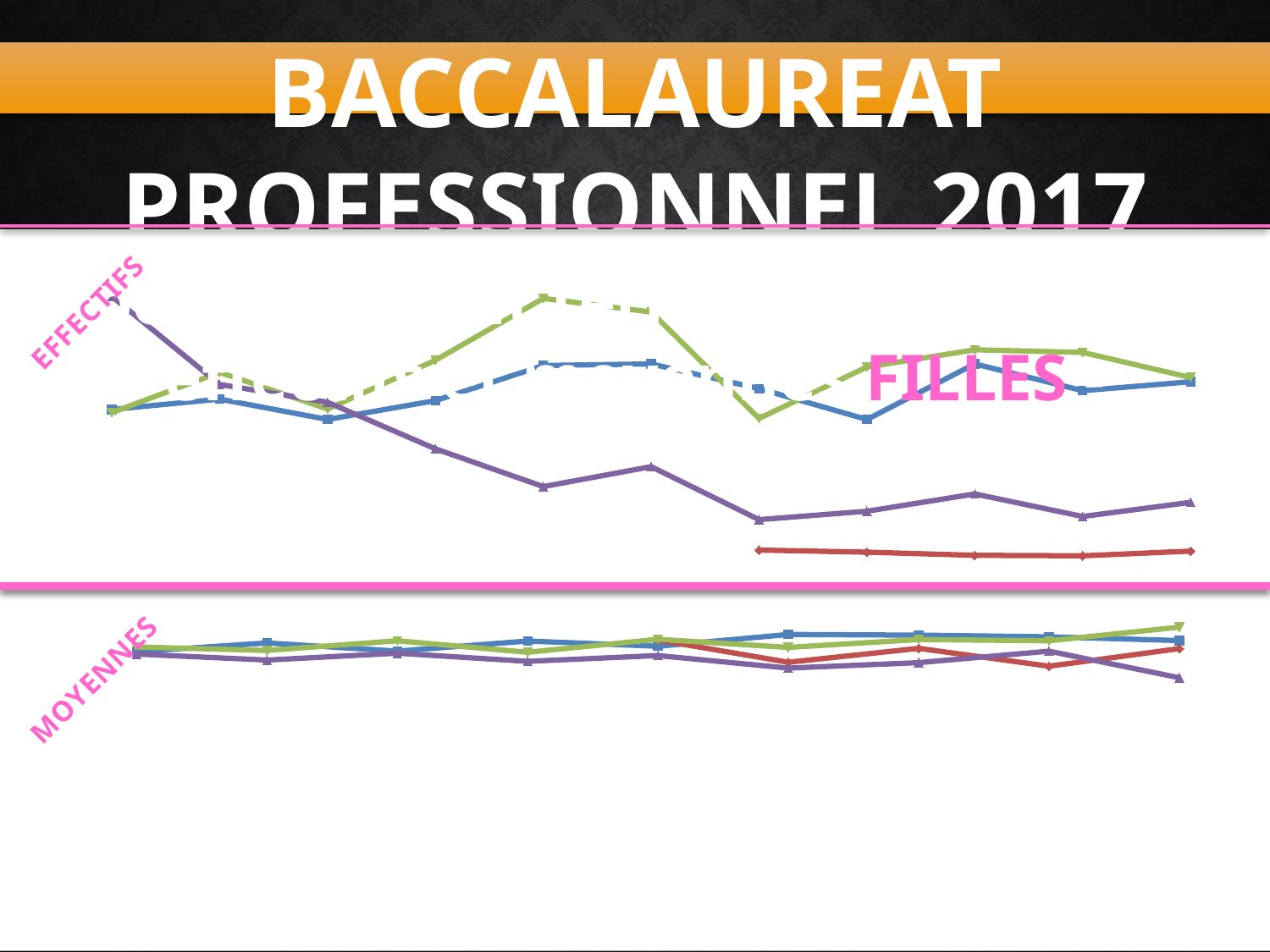
In the top chart (EFFECTIFS), does the purple line rise or fall overall from left to right? fall In the bottom chart (MOYENNES), which coloured line is the lowest at the right-hand end? purple In the bottom chart (MOYENNES), does the purple line rise or fall overall from left to right? fall What kind of chart is the bottom chart labelled MOYENNES? line chart What kind of chart is the top chart labelled EFFECTIFS? line chart In the top chart (EFFECTIFS), how many lines are plotted? 4 In the top chart (EFFECTIFS), which coloured line is the lowest at the right-hand end? red In the bottom chart (MOYENNES), how many lines are plotted? 4 What is the pink label written beside the top chart? EFFECTIFS In the top chart (EFFECTIFS), which coloured line is the highest at the left-hand end? purple What is the pink label written beside the bottom chart? MOYENNES